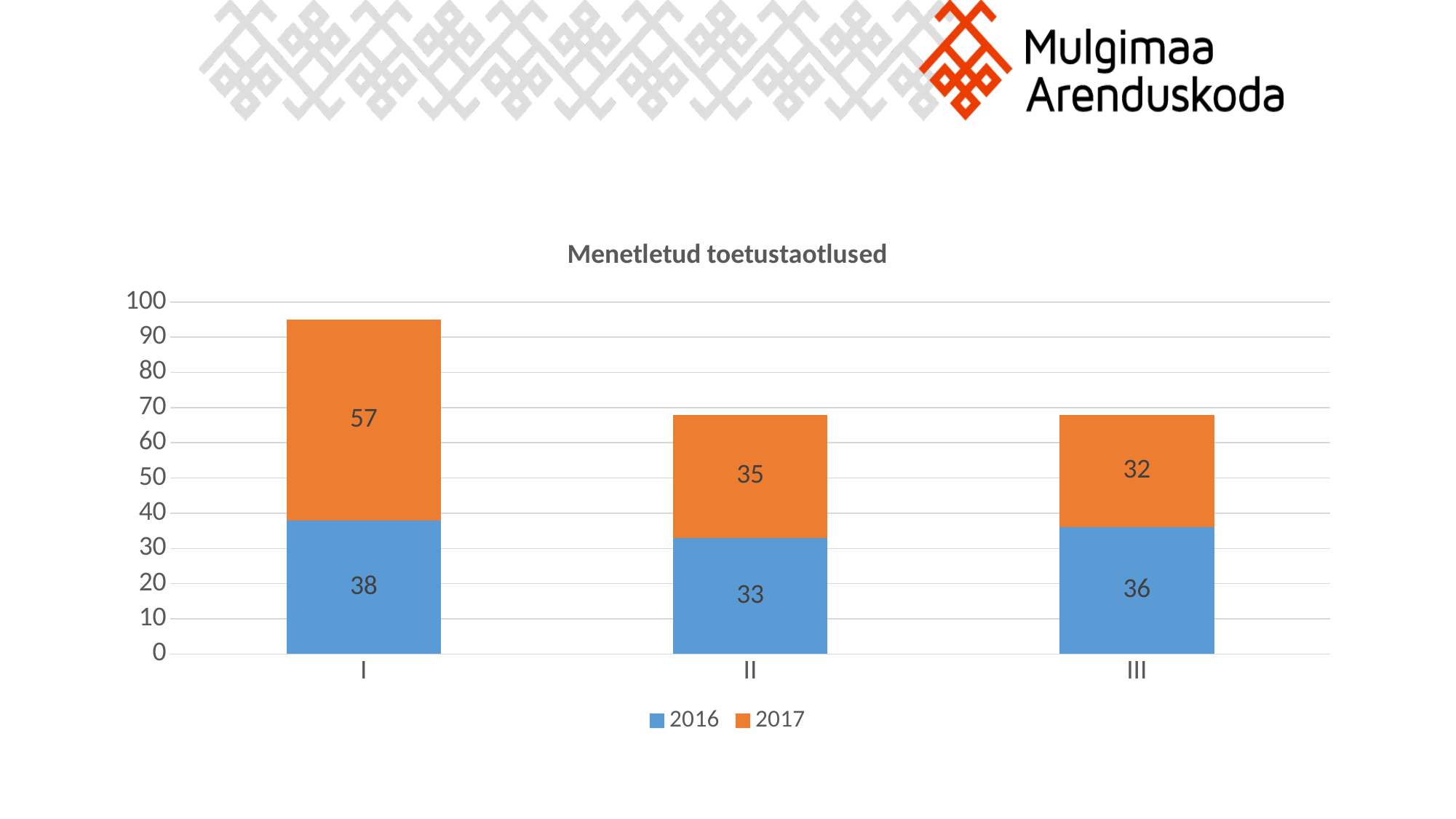
What is the difference between the 2017 values for categories I and II? 22 What is the value for 2017 in category II? 35 What is the value for 2017 in category III? 32 Which category has the highest value for the 2017 series? I What is the total of the stacked bar for category I? 95 Which is larger: the 2016 value for category III or the 2017 value for category III? 2016 value for category III What is the value for 2016 in category I? 38 Which category has the lowest value for the 2016 series? II How many categories are shown on the x axis? 3 What is the total of the stacked bar for category II? 68 How many series does the legend list? 2 What is the title of the chart? Menetletud toetustaotlused